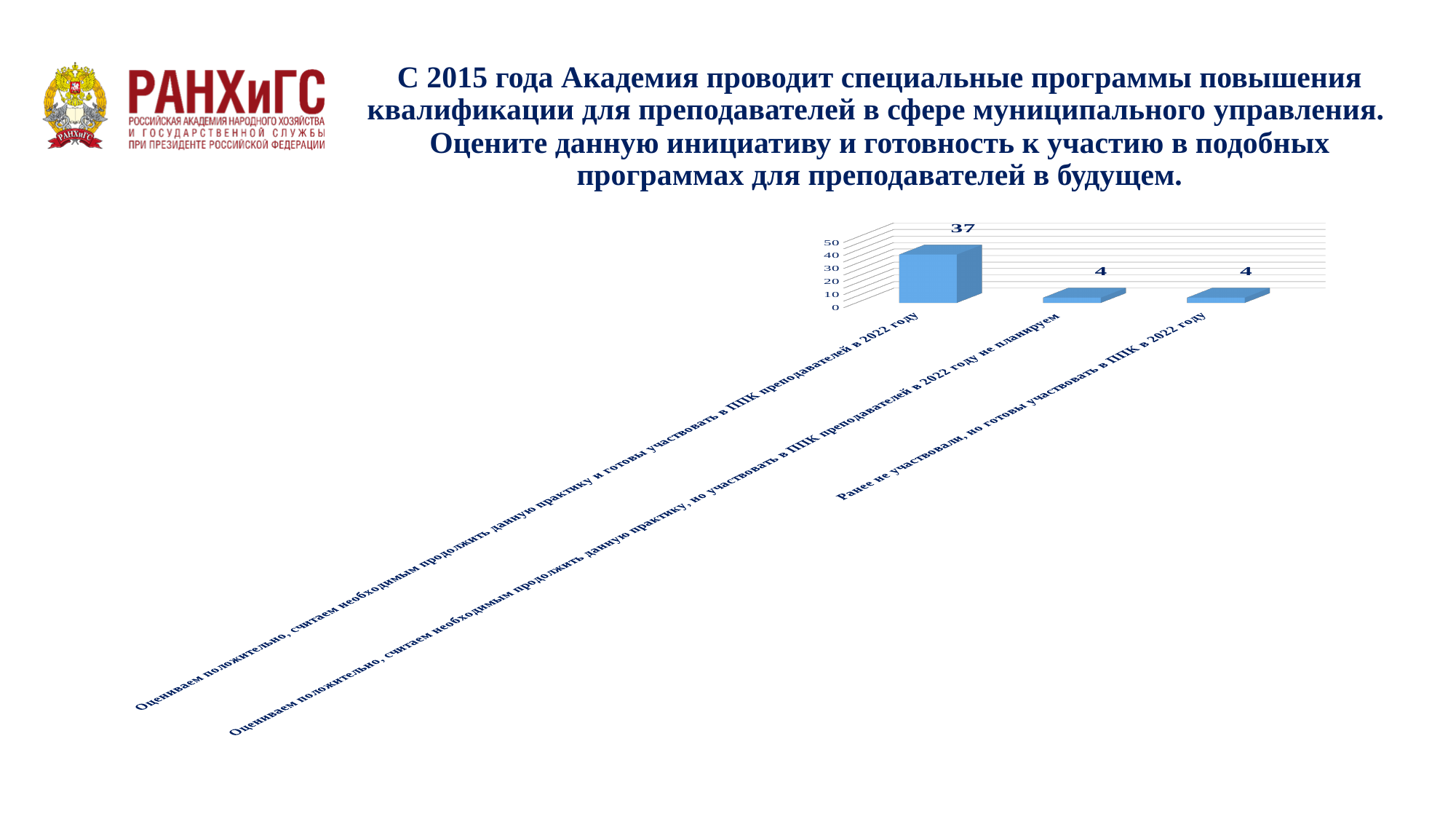
What kind of chart is shown on the slide? bar chart What is the value for the category "Ранее не участвовали, но готовы участвовать в ППК в 2022 году"? 4 Is the value for "Оцениваем положительно, считаем необходимым продолжить данную практику и готовы участвовать в ППК преподавателей в 2022 году" greater or less than 30? greater Is the value for "Ранее не участвовали, но готовы участвовать в ППК в 2022 году" greater or less than 10? less What is the difference between the value for "Оцениваем положительно, считаем необходимым продолжить данную практику и готовы участвовать в ППК преподавателей в 2022 году" and the value for "Ранее не участвовали, но готовы участвовать в ППК в 2022 году"? 33 What is the value for the category "Оцениваем положительно, считаем необходимым продолжить данную практику и готовы участвовать в ППК преподавателей в 2022 году"? 37 What is the highest tick value shown on the vertical axis of the chart? 50 Which is larger: the value for "Оцениваем положительно, считаем необходимым продолжить данную практику и готовы участвовать в ППК преподавателей в 2022 году" or the value for "Ранее не участвовали, но готовы участвовать в ППК в 2022 году"? Оцениваем положительно, считаем необходимым продолжить данную практику и готовы участвовать в ППК преподавателей в 2022 году What is the total of all three values shown in the chart? 45 Which category has the highest value? Оцениваем положительно, считаем необходимым продолжить данную практику и готовы участвовать в ППК преподавателей в 2022 году What is the value for the category "Оцениваем положительно, считаем необходимым продолжить данную практику, но участвовать в ППК преподавателей в 2022 году не планируем"? 4 How many categories are shown in the chart? 3